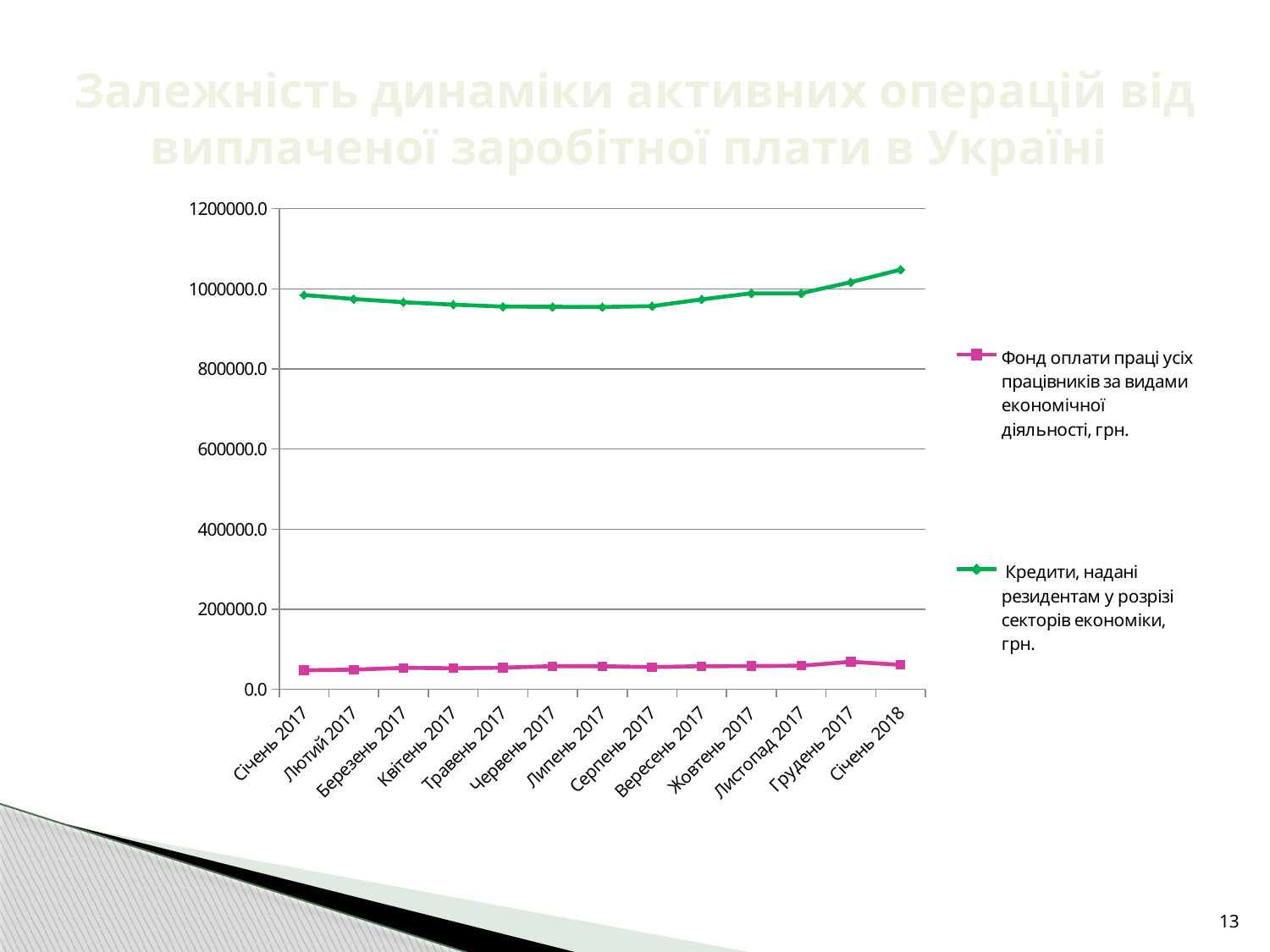
What kind of chart is shown on the slide? Line chart Is the value of 'Кредити, надані резидентам у розрізі секторів економіки, грн.' for Січень 2018 greater or less than 1000000.0? greater Which series has the higher value in Січень 2017: 'Фонд оплати праці' or 'Кредити, надані резидентам'? Кредити, надані резидентам у розрізі секторів економіки, грн. Does the 'Кредити, надані резидентам' series rise or fall between Вересень 2017 and Січень 2018? Rise How many months (points) are plotted along the x axis? 13 In which month does the 'Кредити, надані резидентам у розрізі секторів економіки, грн.' series reach its highest value? Січень 2018 How many series does the legend list? 2 Is the value of 'Фонд оплати праці усіх працівників за видами економічної діяльності, грн.' for Грудень 2017 greater or less than 200000.0? less In which month does the 'Фонд оплати праці усіх працівників за видами економічної діяльності, грн.' series reach its highest value? Грудень 2017 What is the title of the chart on the slide? Залежність динаміки активних операцій від виплаченої заробітної плати в Україні Which colour is used for the 'Кредити, надані резидентам у розрізі секторів економіки, грн.' series? Green Is the value of 'Кредити, надані резидентам у розрізі секторів економіки, грн.' for Липень 2017 greater or less than 1000000.0? less